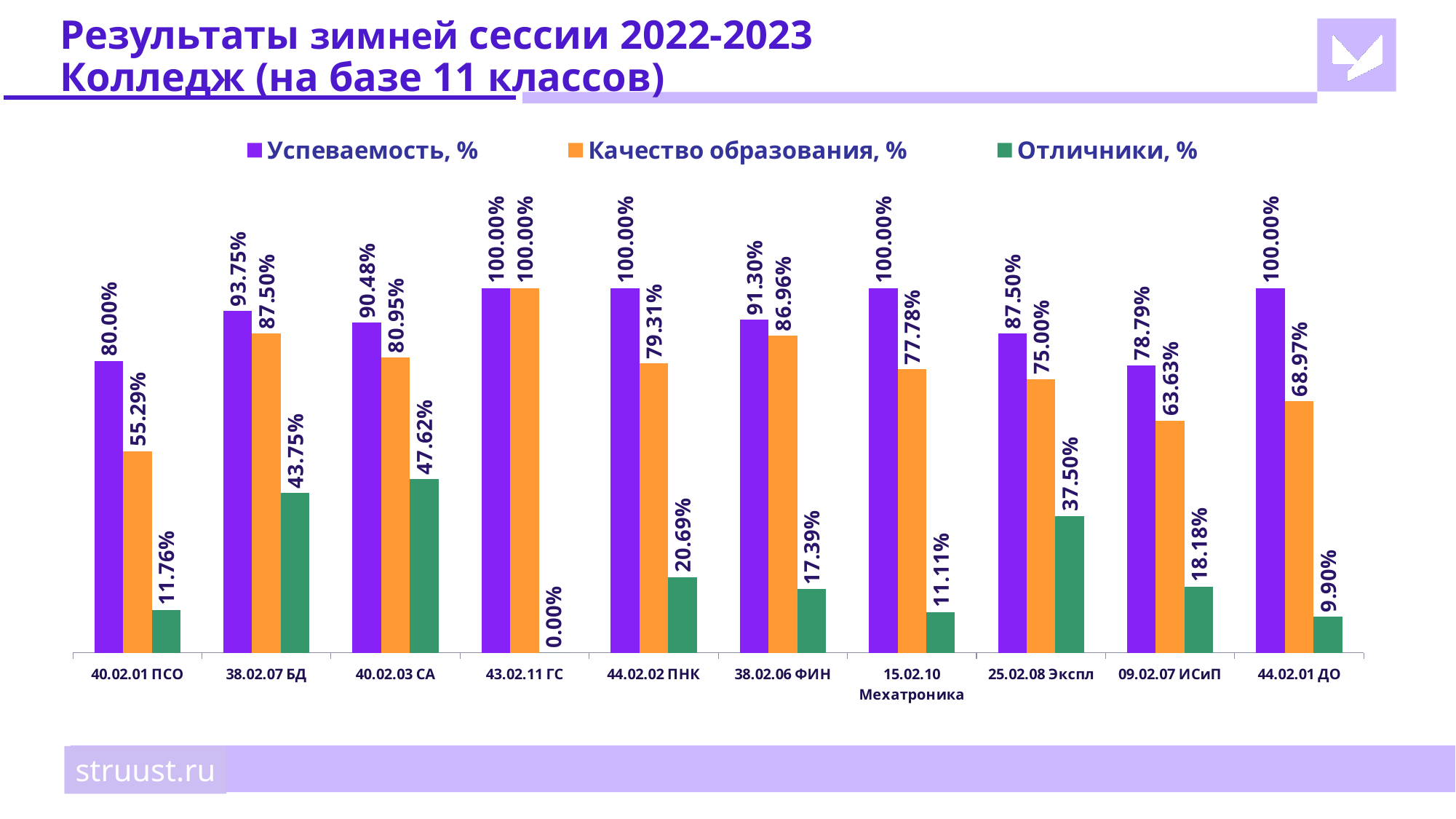
Which is larger for 38.02.06 ФИН: Качество образования, % or Отличники, %? Качество образования, % What kind of chart is shown on the slide? Bar chart What is the Отличники, % value for 15.02.10 Мехатроника? 11.11% What is the Успеваемость, % value for 40.02.01 ПСО? 80.00% Which category has the lowest Успеваемость, % value? 09.02.07 ИСиП What is the Качество образования, % value for 09.02.07 ИСиП? 63.63% Which category has the lowest Качество образования, % value? 40.02.01 ПСО What is the difference between Успеваемость, % and Качество образования, % for 25.02.08 Экспл? 12.50% Which category has the highest Отличники, % value? 40.02.03 СА How many series does the legend list? 3 How many categories are shown on the x axis? 10 Which colour represents the Отличники, % series? Green